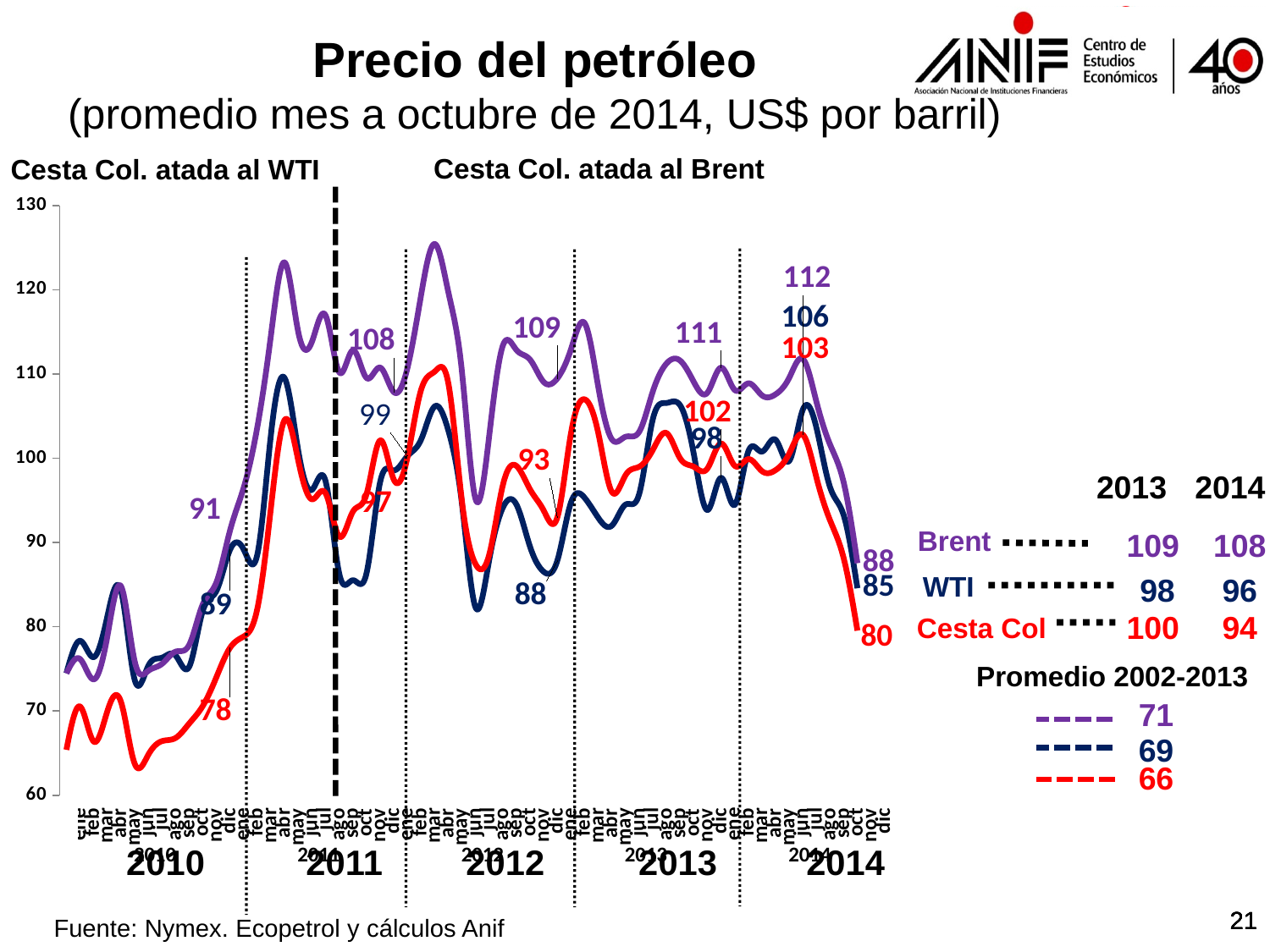
What is the labelled value of Cesta Col at the end of the series (October 2014)? 80 How many series are plotted in the chart? 3 Which series has the lowest labelled value in December 2010? Cesta Col What is the labelled value of WTI in December 2012? 88 What is the difference between the labelled Brent value (112) and the labelled WTI value (106) at the mid-2014 peak? 6 According to the table, what is the 2014 average for Cesta Col? 94 Which is larger in December 2012, the labelled Cesta Col value or the labelled WTI value? Cesta Col What kind of chart is shown on the slide? line chart According to the table, what is the 2002-2013 average (Promedio) for Brent? 71 What is the labelled peak value of Brent in mid-2014? 112 What is the labelled value of Brent at the end of the series (October 2014)? 88 Do the three series rise or fall between June 2014 and October 2014? fall